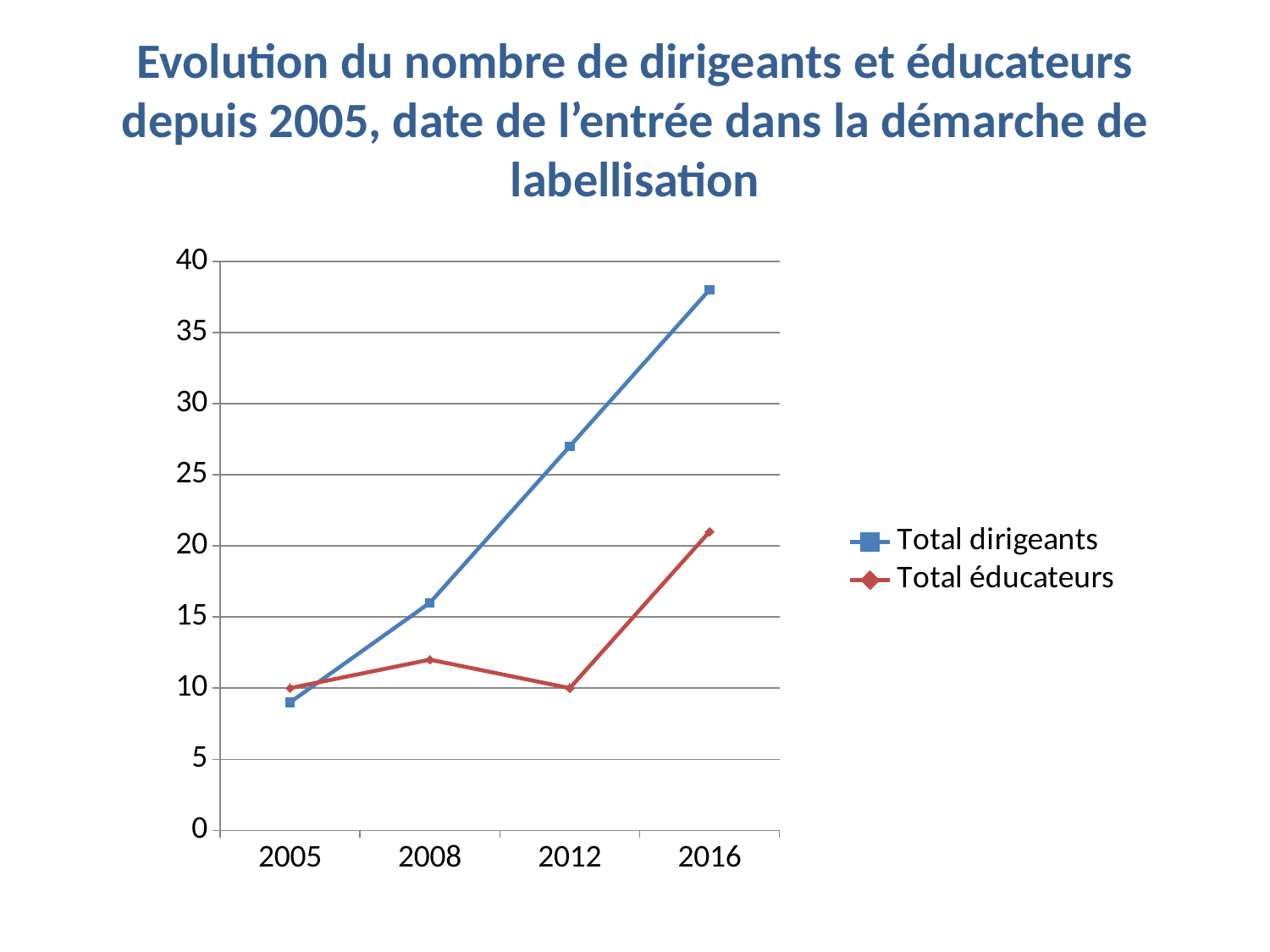
Is the value for Total dirigeants in 2016 greater or less than 35? greater In which year is Total dirigeants highest? 2016 How many years are plotted along the x axis? 4 What kind of chart is shown on the slide? line chart How many series does the legend list? 2 Which series has the larger value in 2012, Total dirigeants or Total éducateurs? Total dirigeants Does the Total dirigeants line rise or fall from 2005 to 2016? rise Is the value for Total éducateurs in 2016 greater or less than 20? greater Is the value for Total dirigeants in 2005 greater or less than 10? less What is the value for Total éducateurs in 2012? 10 What is the value for Total éducateurs in 2005? 10